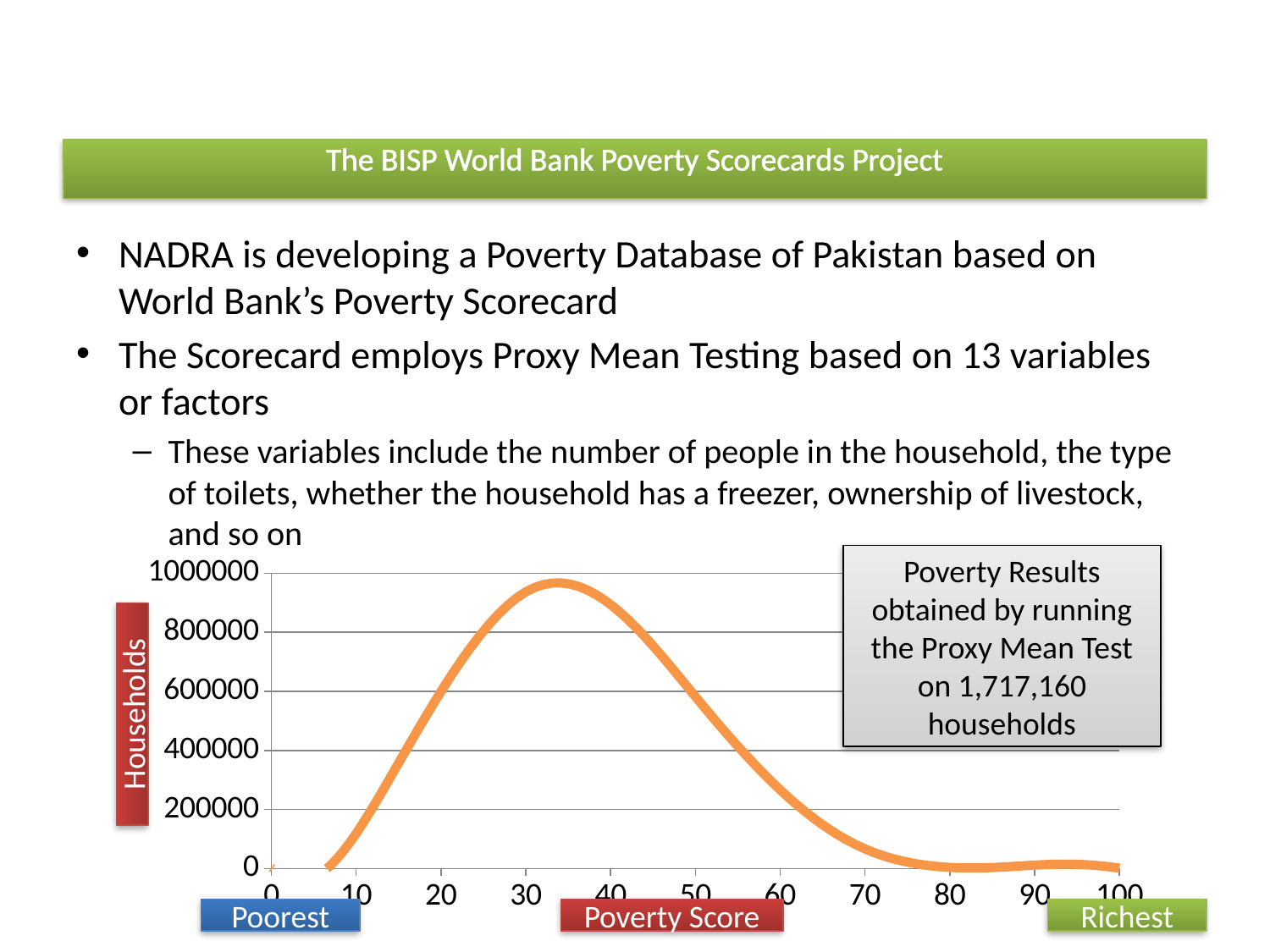
Does the curve rise or fall as the poverty score increases from 40 to 70? fall What is the label on the vertical axis of the chart? Households What kind of chart is shown on the slide? line chart Is the number of households at a poverty score of 80 greater or less than 200000? less Does the curve rise or fall as the poverty score increases from 10 to 30? rise Which has more households, a poverty score of 30 or a poverty score of 70? 30 What is the label on the horizontal axis of the chart? Poverty Score Is the number of households at a poverty score of 60 greater or less than 400000? less Is the peak value of the curve greater or less than 800000 households? greater Which has more households, a poverty score of 10 or a poverty score of 50? 50 What is the highest value shown on the vertical axis of the chart? 1000000